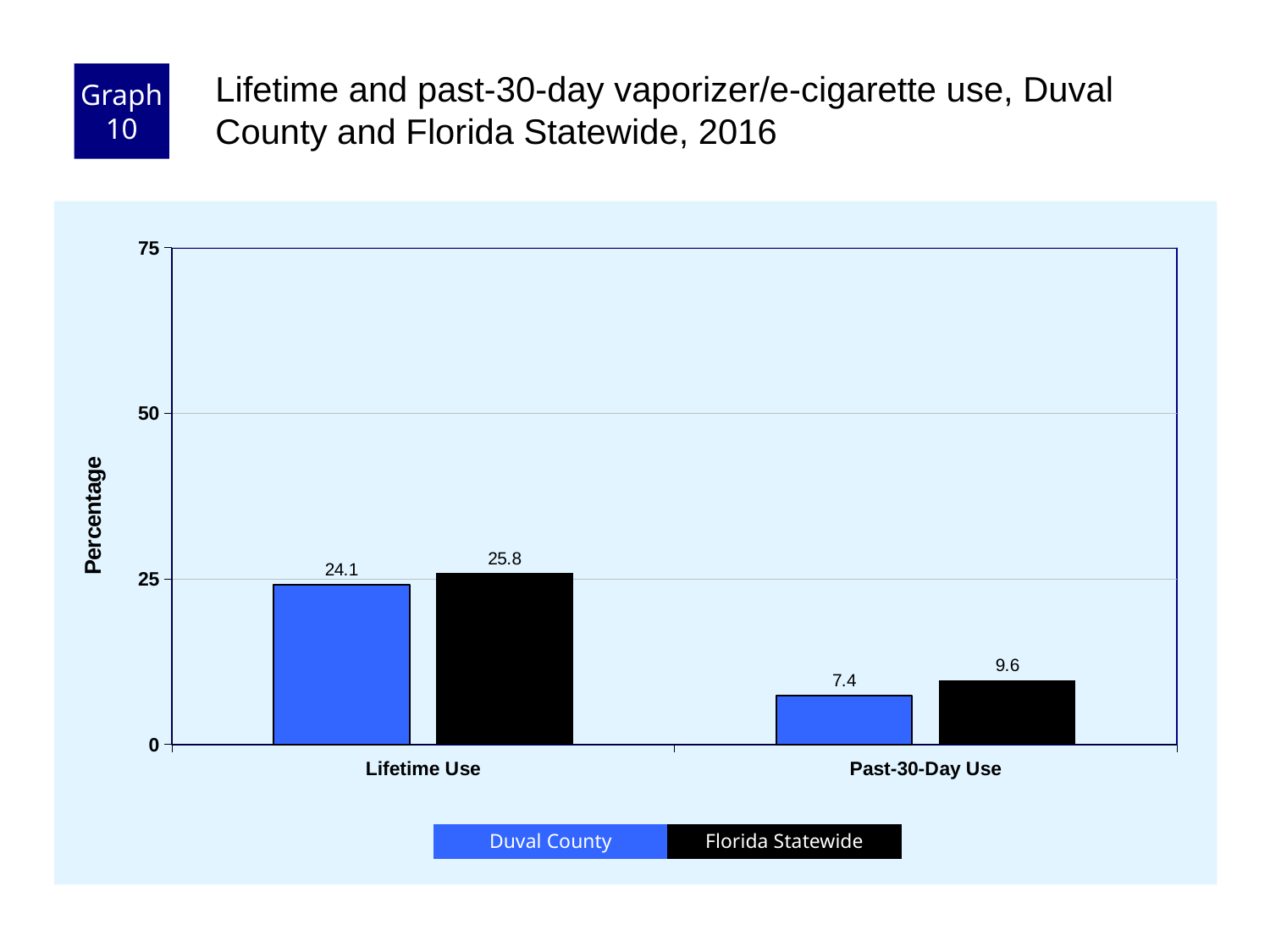
What is the difference between the Florida Statewide and Duval County values for Lifetime Use? 1.7 How many categories are shown on the x axis? 2 For Lifetime Use, which is larger: Duval County or Florida Statewide? Florida Statewide Is the Duval County value for Past-30-Day Use greater or less than 25? less Which category has the highest Duval County value? Lifetime Use What is the Duval County value for Lifetime Use? 24.1 Which category has the lowest Florida Statewide value? Past-30-Day Use What is the Florida Statewide value for Past-30-Day Use? 9.6 How many series does the legend list? 2 What kind of chart is shown on the slide? bar chart What is the difference between the Florida Statewide and Duval County values for Past-30-Day Use? 2.2 What is the Florida Statewide value for Lifetime Use? 25.8